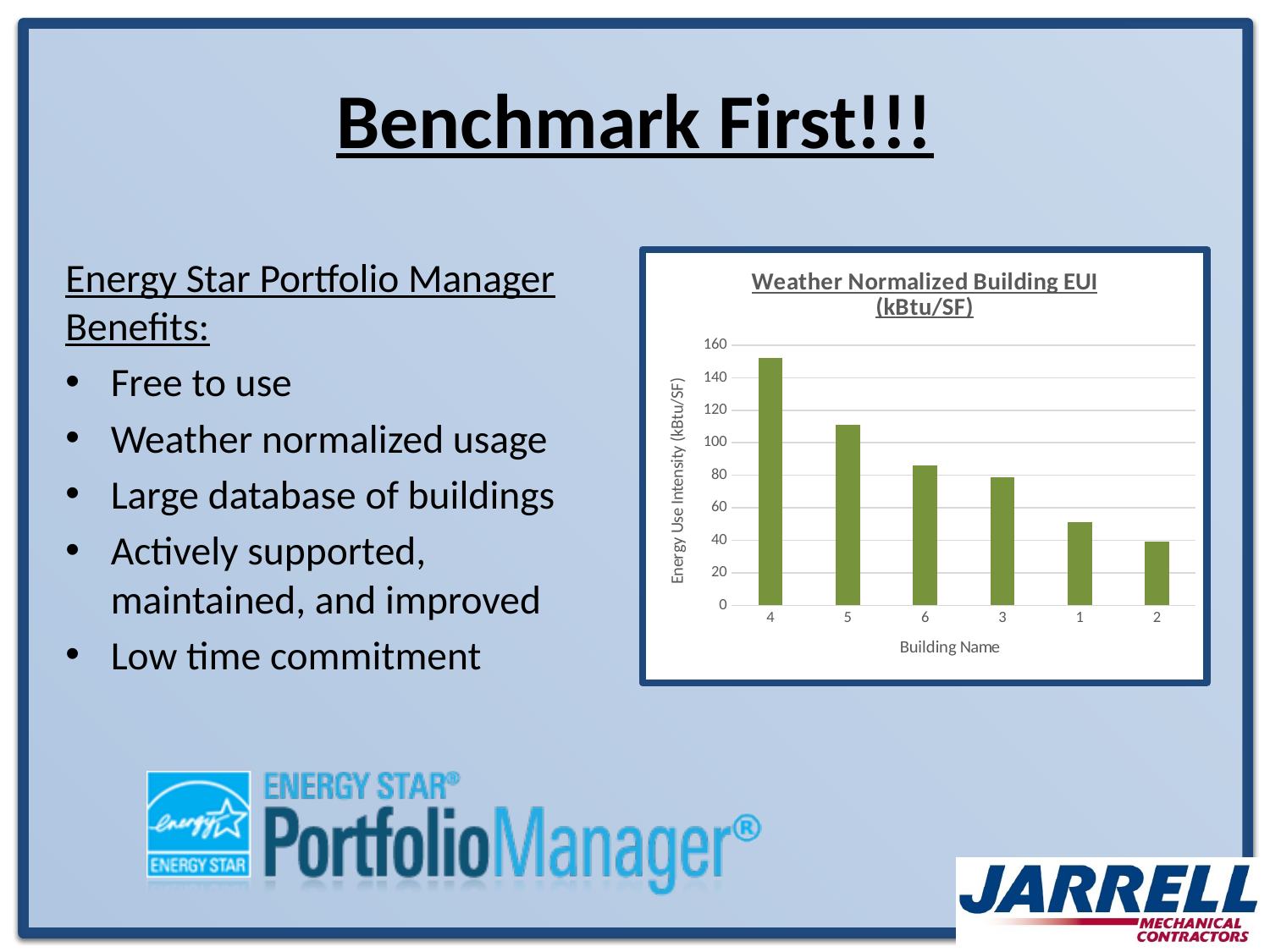
Is the value for building 5 greater or less than 100? greater Is the value for building 1 greater or less than 60? less Which has a higher Energy Use Intensity, building 5 or building 3? 5 Is the value for building 4 greater or less than 140? greater Which building has the lowest Energy Use Intensity? 2 How many buildings are plotted in the chart? 6 What kind of chart is shown on the slide? bar chart What is the title of the chart? Weather Normalized Building EUI (kBtu/SF) What is the label on the x axis of the chart? Building Name Do the values rise or fall moving from left to right along the x axis? fall Which building has the highest Energy Use Intensity? 4